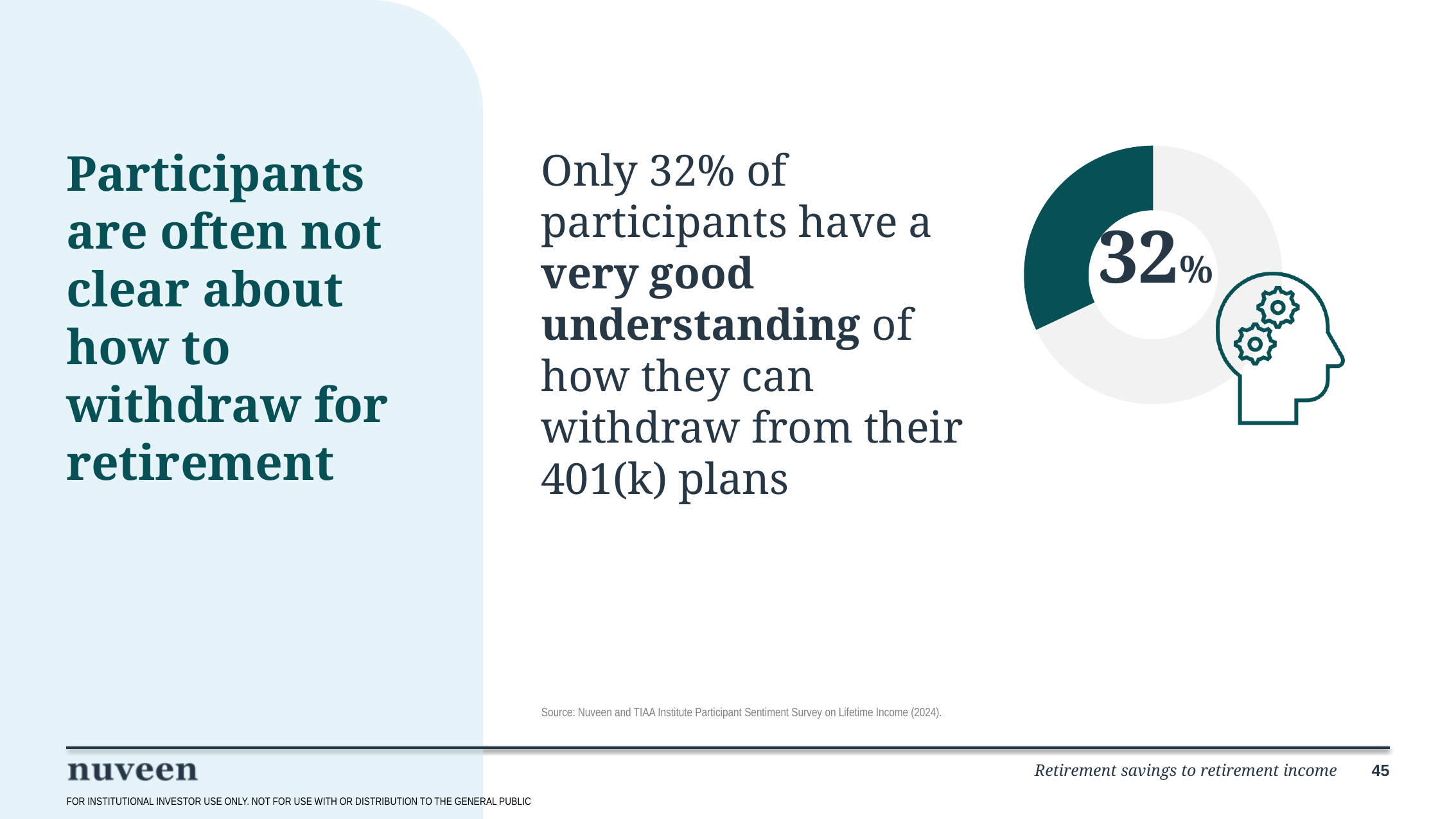
How many segments does the donut chart have? 2 What share of participants have a very good understanding of how they can withdraw from their 401(k) plans, according to the chart? 32% Which portion of the donut chart is larger: the dark teal segment or the light grey segment? The light grey segment What share of the donut chart is not highlighted in dark teal? 68% What kind of chart is shown on the slide? Donut (pie) chart What colour is the segment of the donut chart representing the 32%? Dark teal Is the highlighted (dark teal) portion of the donut chart greater or less than 50%? less What is the source cited for the chart's data? Nuveen and TIAA Institute Participant Sentiment Survey on Lifetime Income (2024) What percentage is shown in the centre of the donut chart? 32%